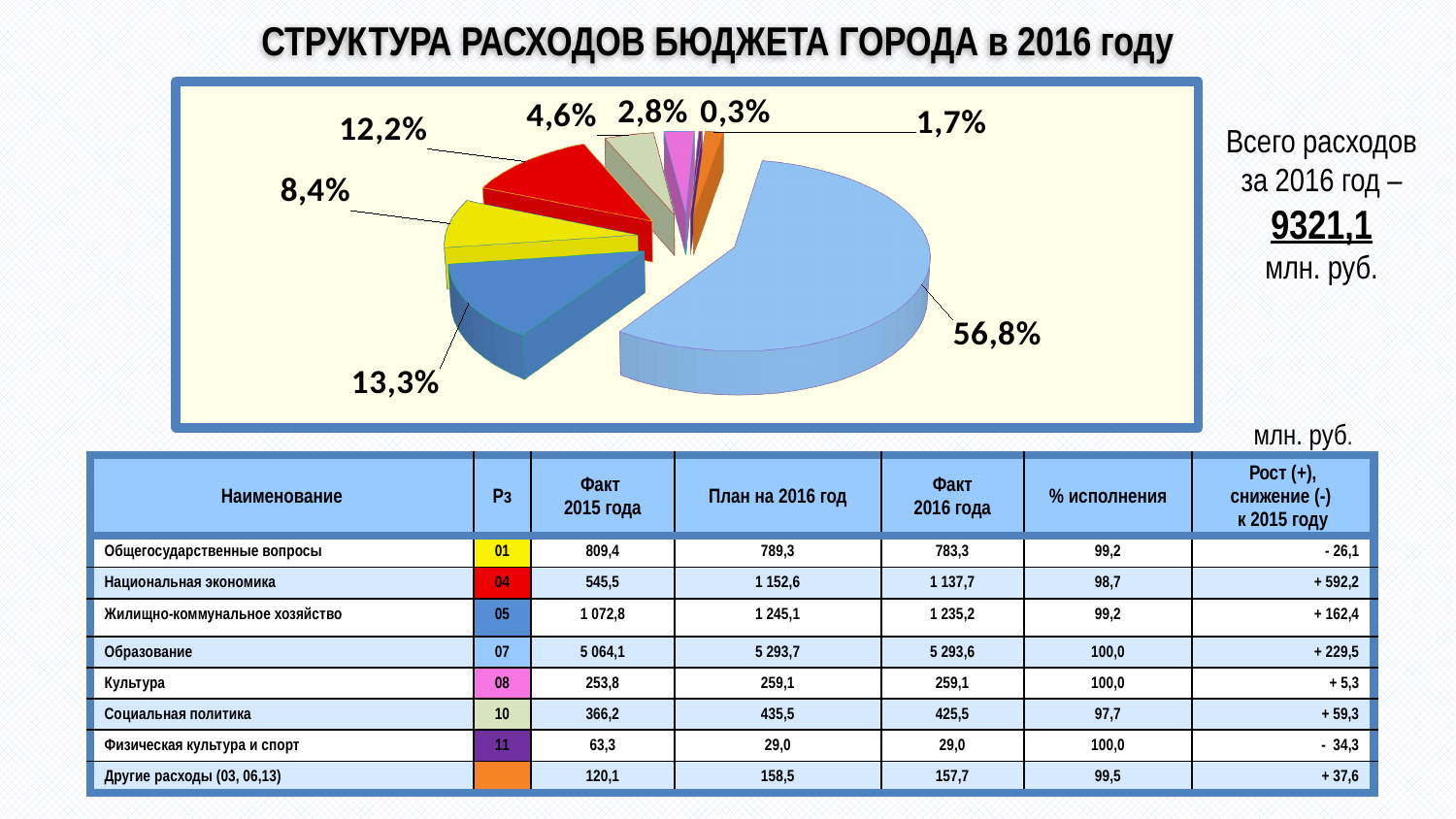
What is the difference between the largest slice (56,8%) and the second largest slice (13,3%) in the pie chart? 43,5% What kind of chart is shown on the slide? pie chart What percentage is labelled on the yellow slice of the pie chart? 8,4% What total expenditure for 2016 is stated next to the pie chart? 9321,1 млн. руб. What is the smallest share shown in the pie chart? 0,3% What percentage is labelled on the red slice of the pie chart? 12,2% What is the title of the slide containing the pie chart? СТРУКТУРА РАСХОДОВ БЮДЖЕТА ГОРОДА в 2016 году What percentage is labelled on the orange slice of the pie chart? 1,7% What is the largest share shown in the pie chart? 56,8% How many slices does the pie chart have? 8 What percentage is labelled on the dark blue slice of the pie chart? 13,3% Which slice is larger in the pie chart, the one labelled 13,3% or the one labelled 12,2%? 13,3%